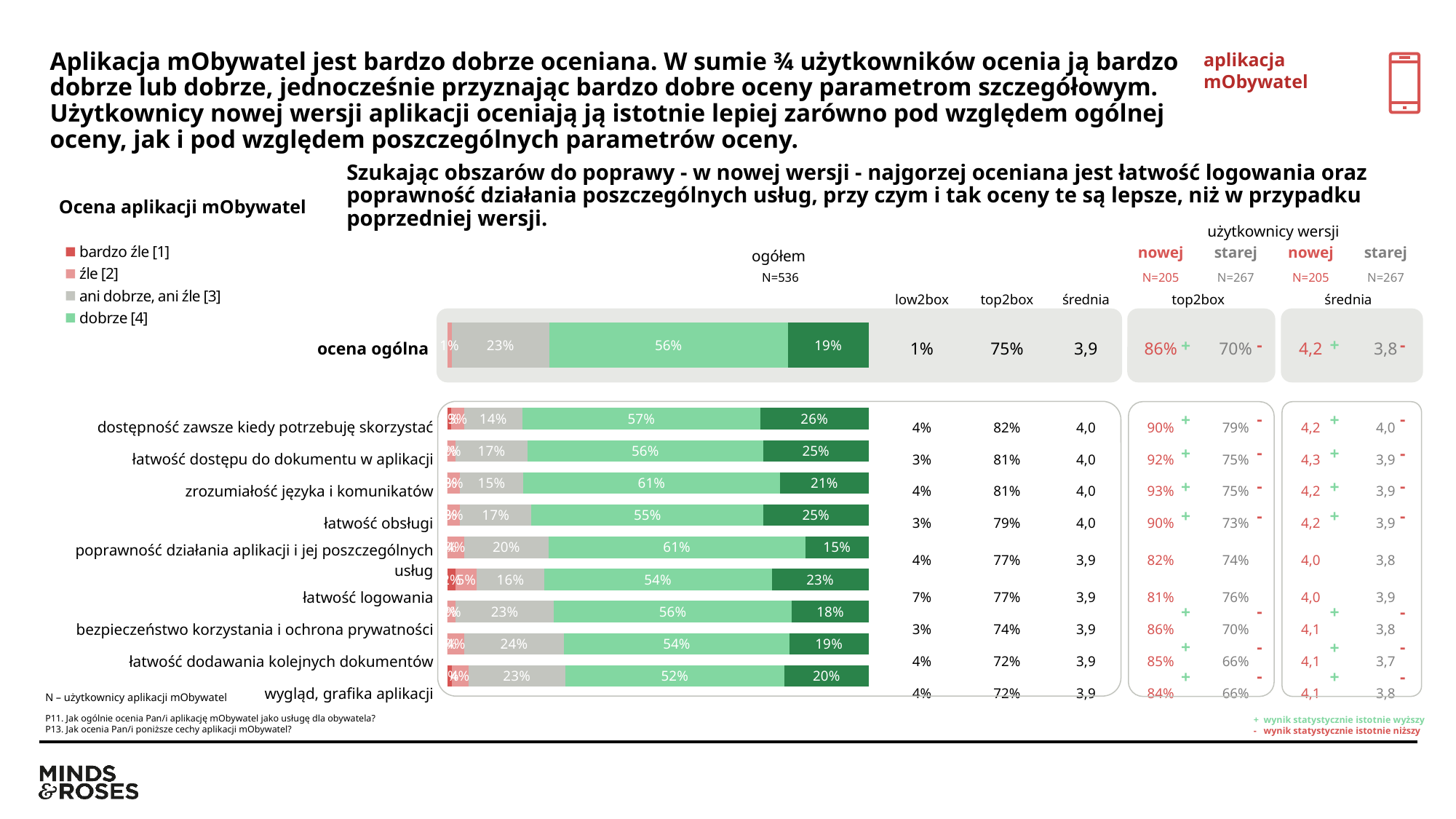
Which detailed parameter has the highest low2box value in the ogółem column? łatwość logowania In the 'ocena ogólna' bar, what percentage is shown for the 'ani dobrze, ani źle [3]' segment? 23% In the 'ocena ogólna' bar, what percentage is shown for the 'dobrze [4]' segment? 56% Which detailed parameter has the highest top2box value in the ogółem column? dostępność zawsze kiedy potrzebuję skorzystać How many detailed parameters (rows below 'ocena ogólna') are shown in the chart? 9 For 'ocena ogólna', what is the difference in top2box between users of the new version (nowej) and the old version (starej)? 16 percentage points What is the top2box value for 'ocena ogólna'? 75% Which has a larger 'dobrze [4]' segment: 'dostępność zawsze kiedy potrzebuję skorzystać' or 'zrozumiałość języka i komunikatów'? zrozumiałość języka i komunikatów What is the 'średnia' value for 'ocena ogólna' in the ogółem column? 3,9 What is the sample size N shown for 'ogółem'? N=536 What kind of chart is used in 'Ocena aplikacji mObywatel'? bar chart What is the 'średnia' for 'ocena ogólna' among users of the new version (nowej)? 4,2